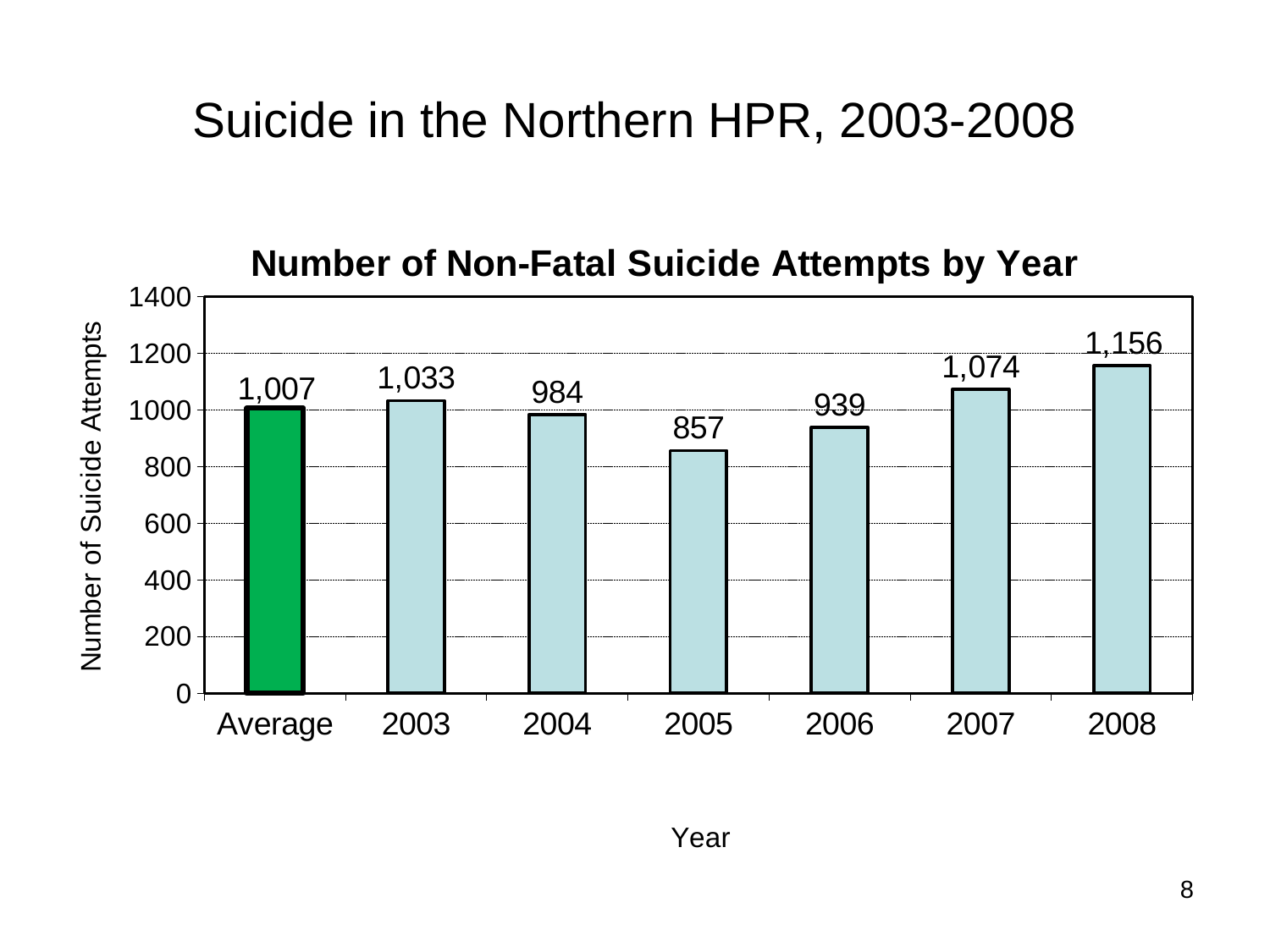
What is the difference between the values for 2003 and 2004? 49 Is the value for 2006 greater or less than 1000? less Which year has the highest number of non-fatal suicide attempts? 2008 What is the difference between the values for 2008 and 2005? 299 Which year has the lowest number of non-fatal suicide attempts? 2005 What is the number of non-fatal suicide attempts for 2005? 857 How many bars are shown in the chart? 7 Which is larger, the value for 2006 or the value for 2004? 2004 What is the title of the chart? Number of Non-Fatal Suicide Attempts by Year What is the number of non-fatal suicide attempts for 2007? 1,074 What kind of chart is shown on the slide? bar chart What is the value of the Average bar? 1,007